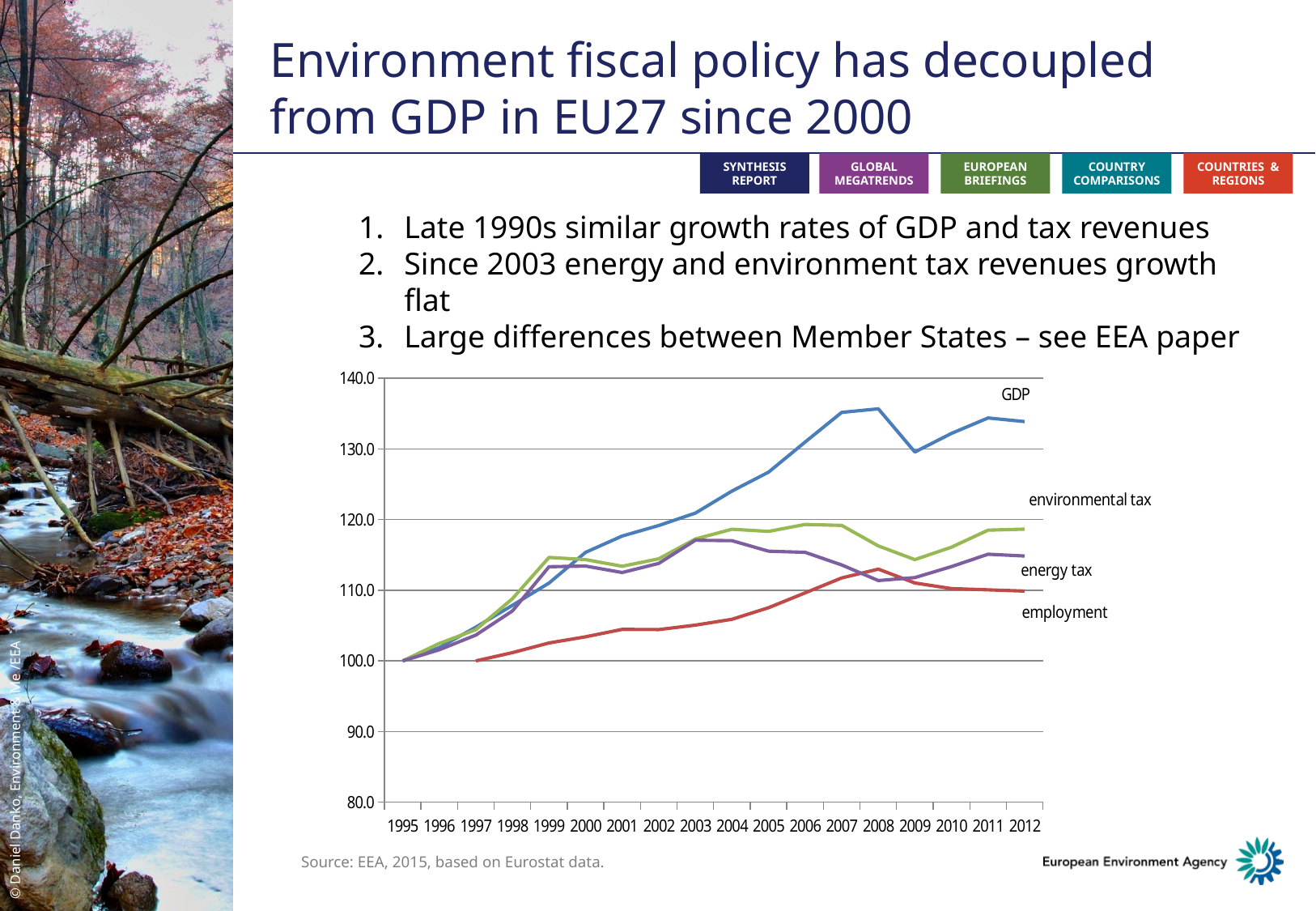
How many years are shown on the x axis of the chart? 18 Is the value for employment in 2005 greater or less than 110.0? less Is the value for GDP in 2008 greater or less than 130.0? greater What kind of chart is shown on the slide? line chart Is the value for energy tax in 2012 greater or less than 110.0? greater Which series has the highest value in 2012? GDP What is the value of employment in 1997? 100.0 In 2010, which is larger: GDP or employment? GDP Does the GDP line rise or fall between 1995 and 2007? rise What is the value of GDP in 1995? 100.0 Which series has the lowest value in 2012? employment How many series are labelled on the chart? 4